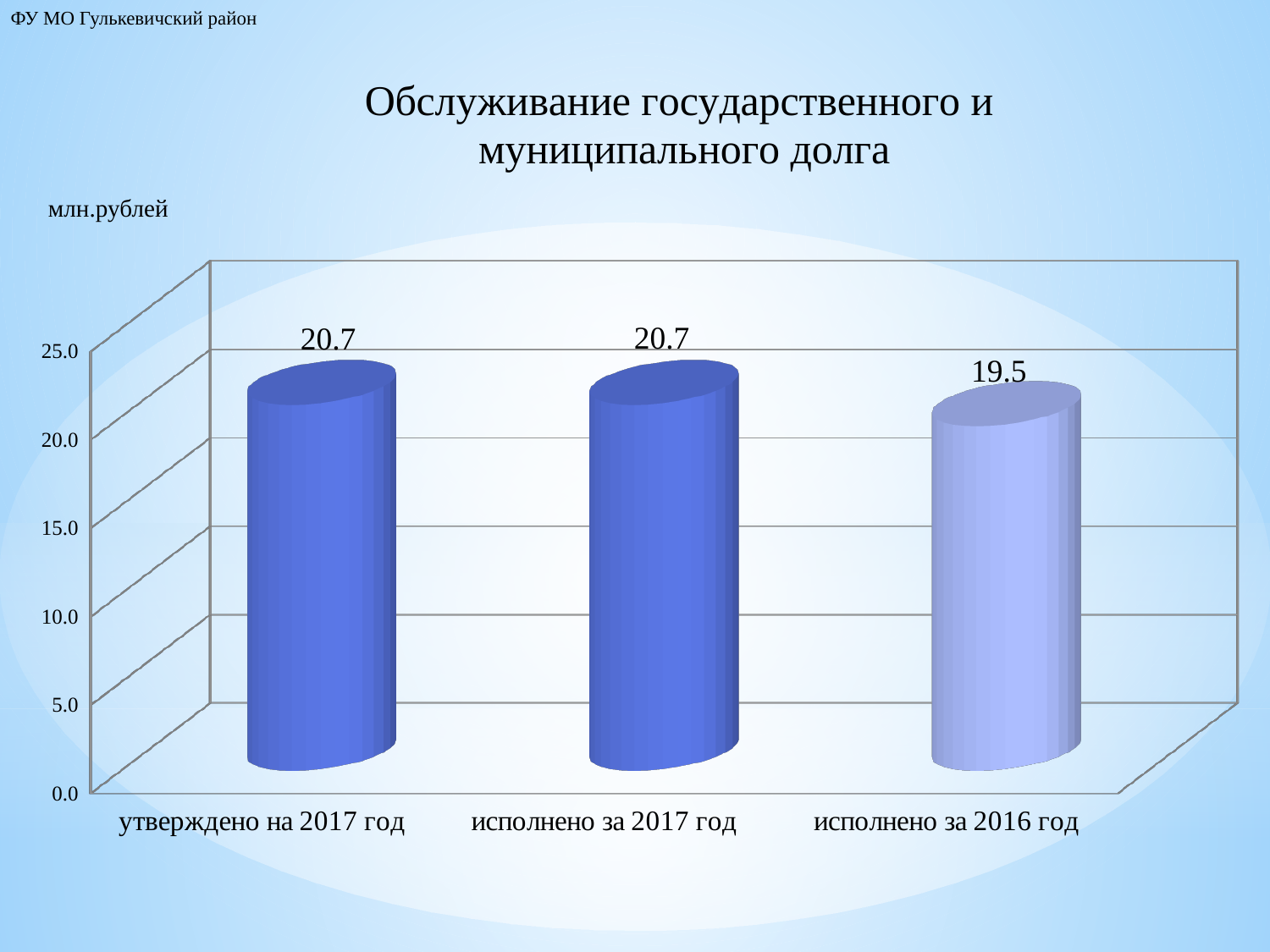
What is the value for 'утверждено на 2017 год'? 20.7 What is the title of the chart? Обслуживание государственного и муниципального долга Which category has the lowest value? исполнено за 2016 год Is the value for 'исполнено за 2016 год' greater or less than 20.0? less What kind of chart is shown on the slide? bar chart Is the value for 'утверждено на 2017 год' greater or less than 20.0? greater What is the value for 'исполнено за 2016 год'? 19.5 Which is larger: the value for 'утверждено на 2017 год' or the value for 'исполнено за 2016 год'? утверждено на 2017 год How many categories are shown on the chart? 3 What is the value for 'исполнено за 2017 год'? 20.7 What unit is indicated for the values on the chart? млн.рублей What is the difference between the value for 'исполнено за 2017 год' and the value for 'исполнено за 2016 год'? 1.2